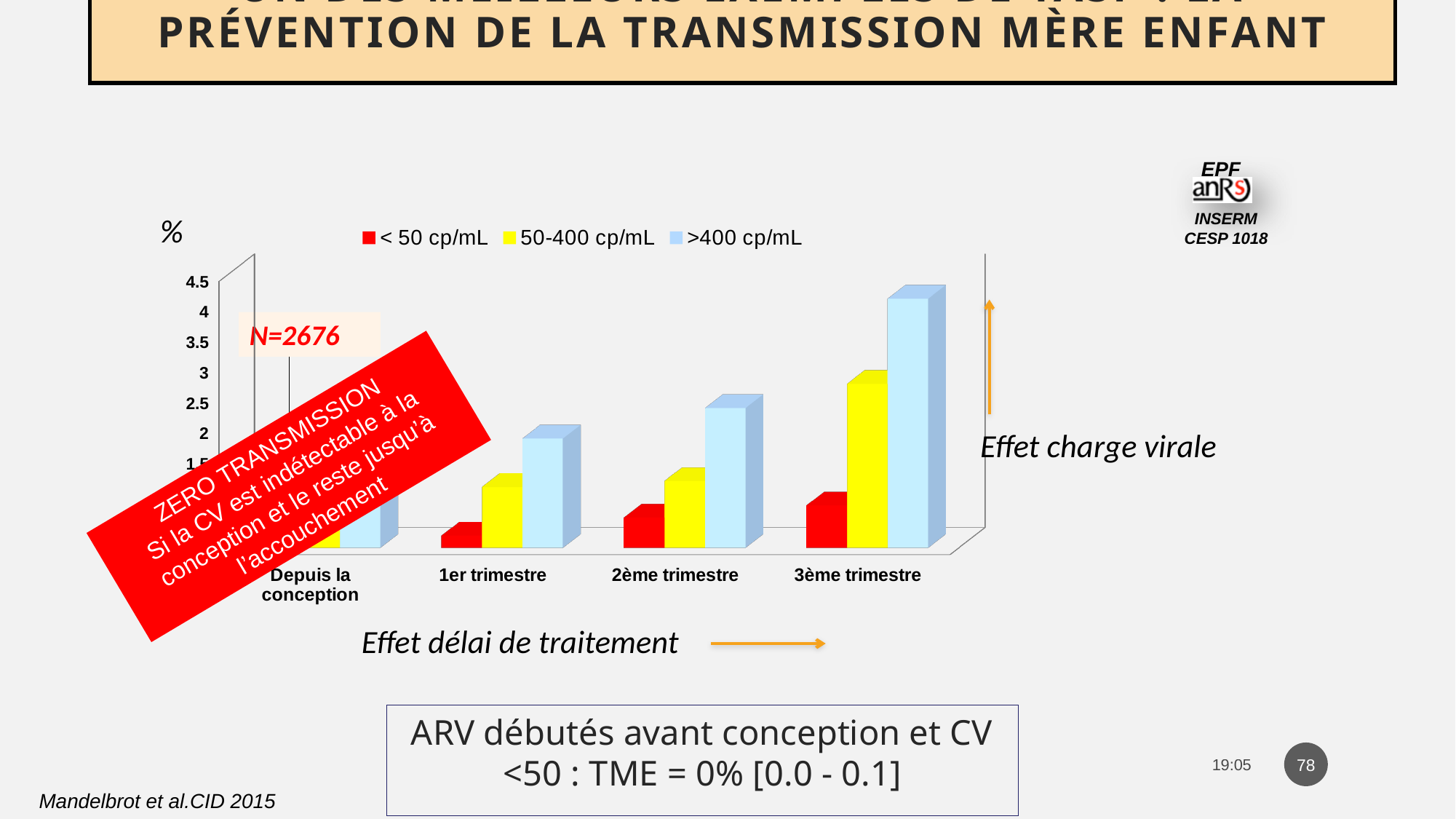
How many categories are shown along the x axis of the chart? 4 What kind of chart is shown on the slide? bar chart Is the value for >400 cp/mL in the 1er trimestre category greater or less than 2.5? less Is the value for < 50 cp/mL in the 1er trimestre category greater or less than 1? less Is the value for >400 cp/mL in the 3ème trimestre category greater or less than 3? greater Do the values for the >400 cp/mL series rise or fall from 1er trimestre to 3ème trimestre? rise Which category has the highest bar for the >400 cp/mL series? 3ème trimestre Which colour represents the < 50 cp/mL series in the chart legend? red What sample size (N) is stated on the chart? N=2676 In the 3ème trimestre category, which series has the larger value: 50-400 cp/mL or >400 cp/mL? >400 cp/mL How many series does the chart legend list? 3